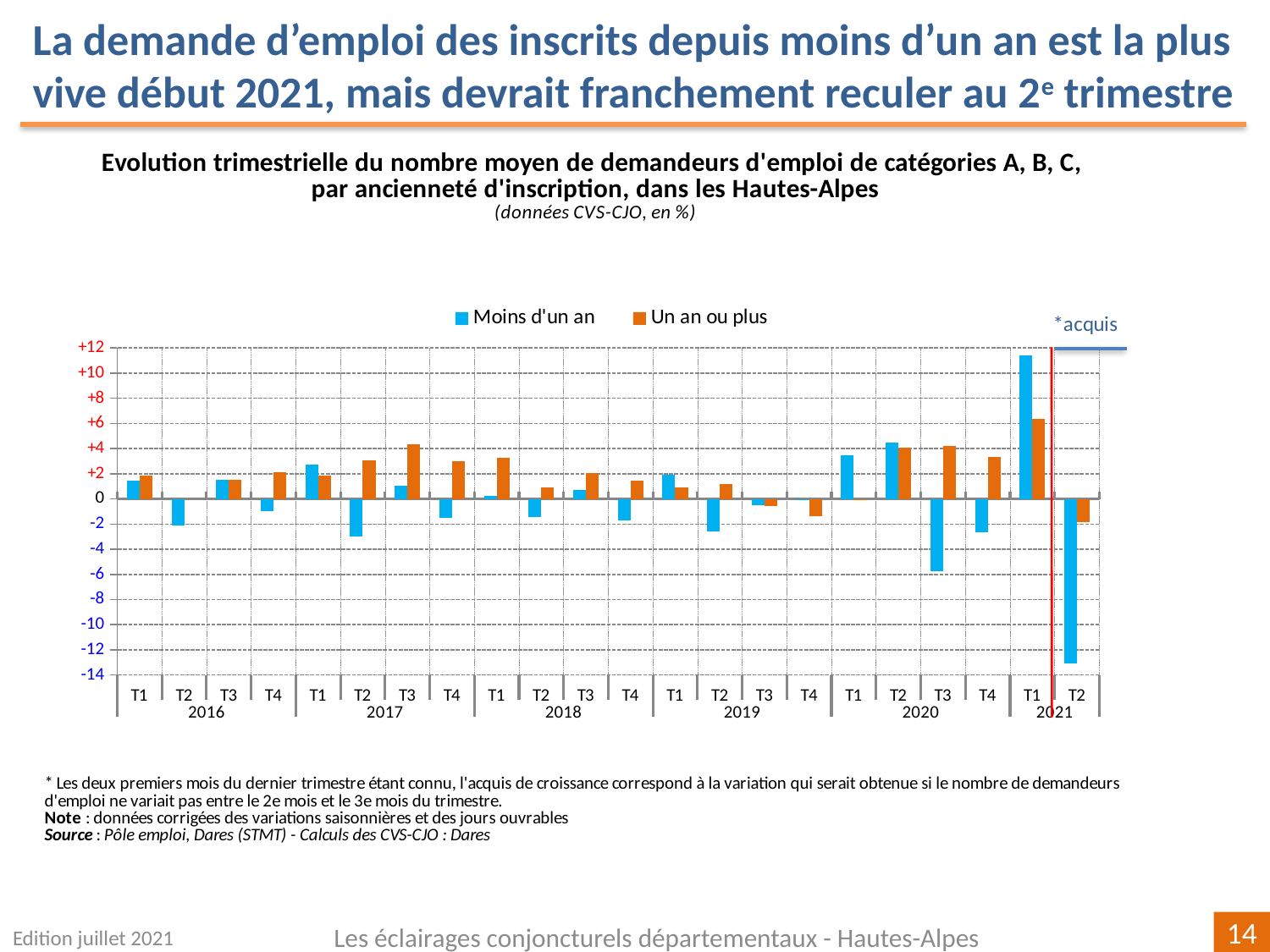
Is the value for 'Moins d'un an' in T2 2021 greater or less than -12? less In T3 2020, which series has the larger value, 'Moins d'un an' or 'Un an ou plus'? Un an ou plus Which quarter has the highest value for the series 'Un an ou plus'? T1 2021 How many quarters are shown on the x axis? 22 Which quarter has the lowest value for the series 'Moins d'un an'? T2 2021 How many series does the legend list? 2 What kind of chart is shown on the slide? bar chart Is the value for 'Moins d'un an' in T1 2021 greater or less than +10? greater Which quarter has the highest value for the series 'Moins d'un an'? T1 2021 Is the value for 'Un an ou plus' in T1 2021 greater or less than +4? greater What colour represents the series 'Moins d'un an'? blue